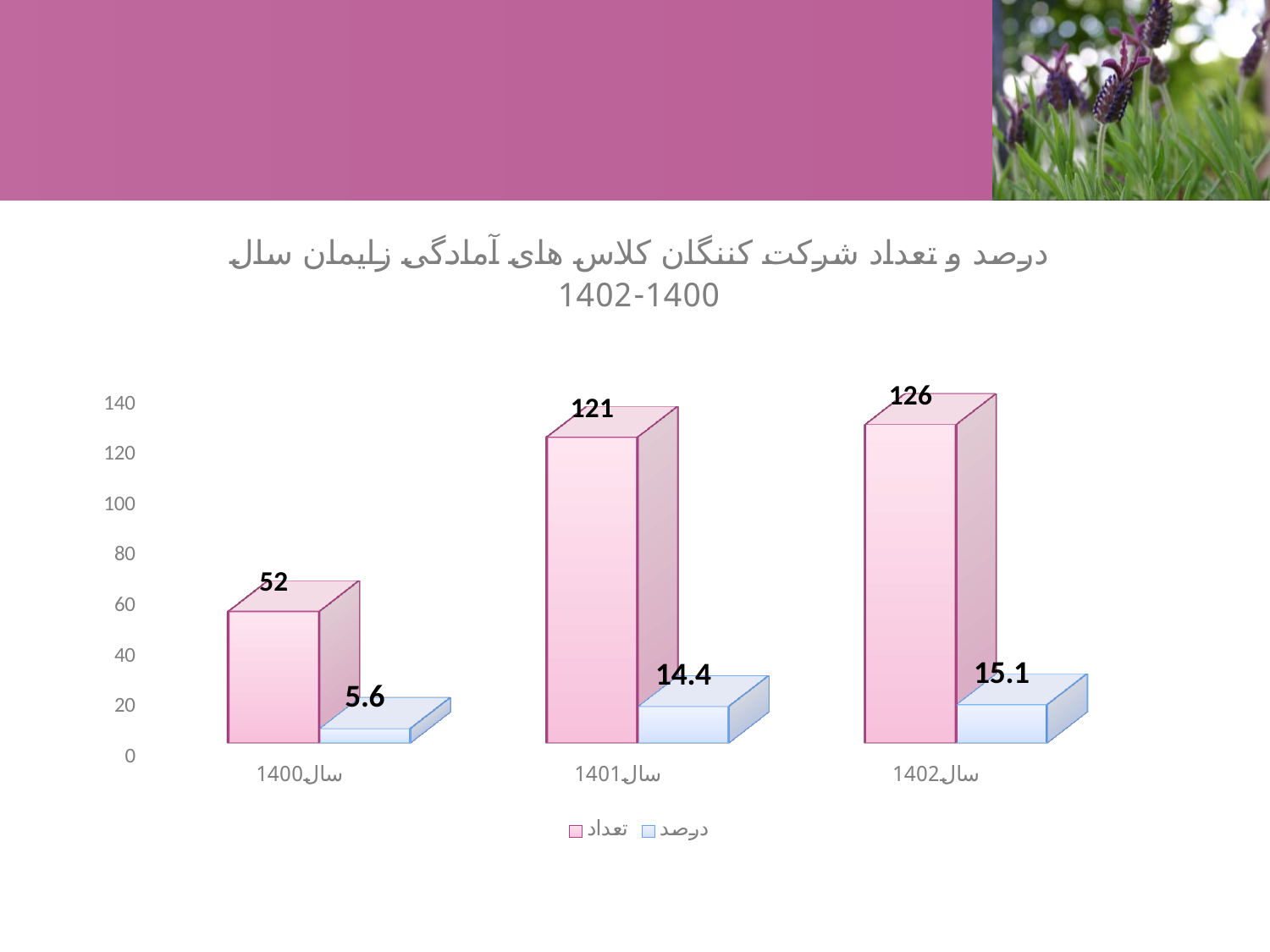
Which is larger, the تعداد value for سال1400 or for سال1402? سال1402 How many series does the legend list? 2 What is the value of درصد for سال1400? 5.6 Do the تعداد values rise or fall from سال1400 to سال1402? rise What kind of chart is shown on the slide? bar chart What is the difference between the درصد values for سال1402 and سال1401? 0.7 What is the difference between the تعداد values for سال1401 and سال1400? 69 What is the value of تعداد for سال1401? 121 Which year has the lowest درصد value? سال1400 How many years (categories) are shown on the x axis? 3 What is the value of درصد for سال1402? 15.1 Which year has the highest تعداد value? سال1402